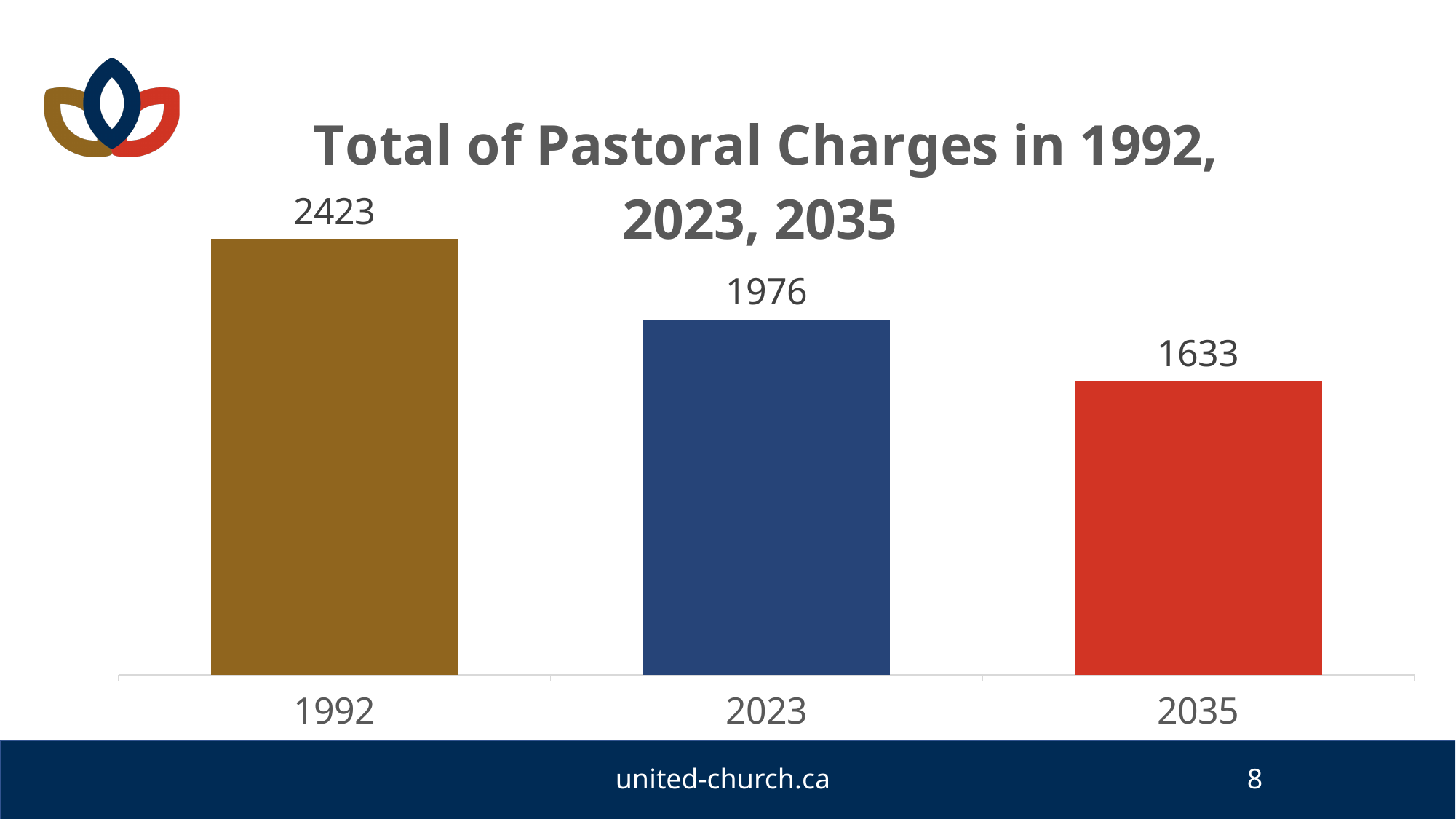
How many years are shown on the chart? 3 What is the difference between the total of pastoral charges in 1992 and in 2023? 447 What is the total of pastoral charges in 1992? 2423 What is the difference between the total of pastoral charges in 1992 and in 2035? 790 Which year has the lowest total of pastoral charges? 2035 Do the values rise or fall from 1992 to 2035? Fall Which is larger, the total of pastoral charges in 2023 or in 2035? 2023 What is the difference between the total of pastoral charges in 2023 and in 2035? 343 What is the total of pastoral charges in 2035? 1633 What is the total of pastoral charges in 2023? 1976 Which year has the highest total of pastoral charges? 1992 What kind of chart is shown on the slide? Bar chart